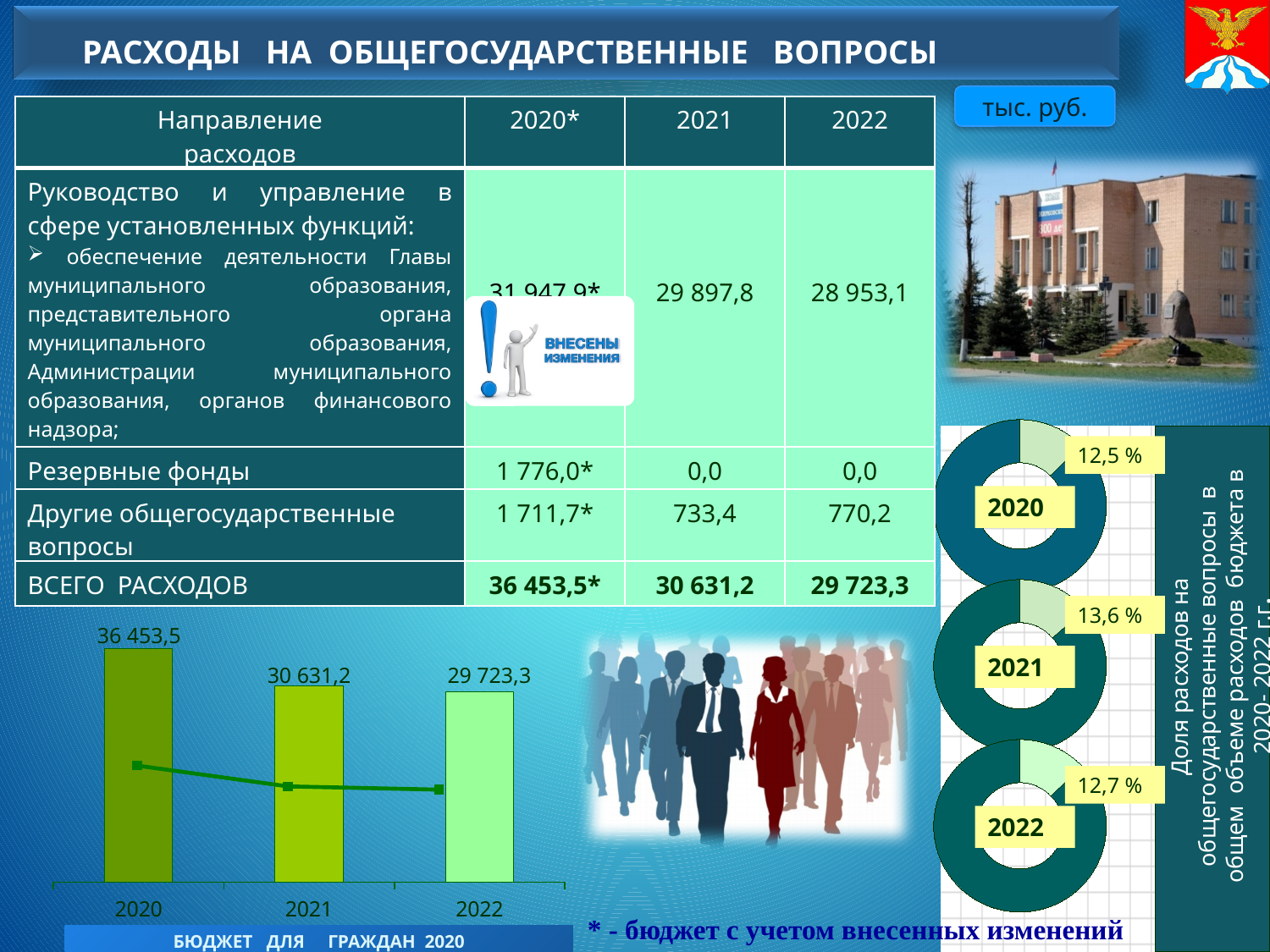
In the bar chart at the bottom left of the slide, what is the difference between the values for 2020 and 2021? 5 822,3 In the bar chart at the bottom left of the slide, which year has the highest value? 2020 In the bar chart at the bottom left of the slide, what is the value for 2021? 30 631,2 In the bar chart at the bottom left of the slide, which year has the lowest value? 2022 In the bar chart at the bottom left of the slide, what is the difference between the values for 2021 and 2022? 907,9 In the bar chart at the bottom left of the slide, what is the value for 2022? 29 723,3 In the donut charts on the right of the slide, what share is shown for 2021? 13,6 % In the bar chart at the bottom left of the slide, how many years are shown on the x axis? 3 In the bar chart at the bottom left of the slide, what is the value for 2020? 36 453,5 In the donut charts on the right of the slide, which year has the highest share? 2021 What kind of chart is shown at the bottom left of the slide? bar chart In the bar chart at the bottom left of the slide, do the values rise or fall from 2020 to 2022? fall